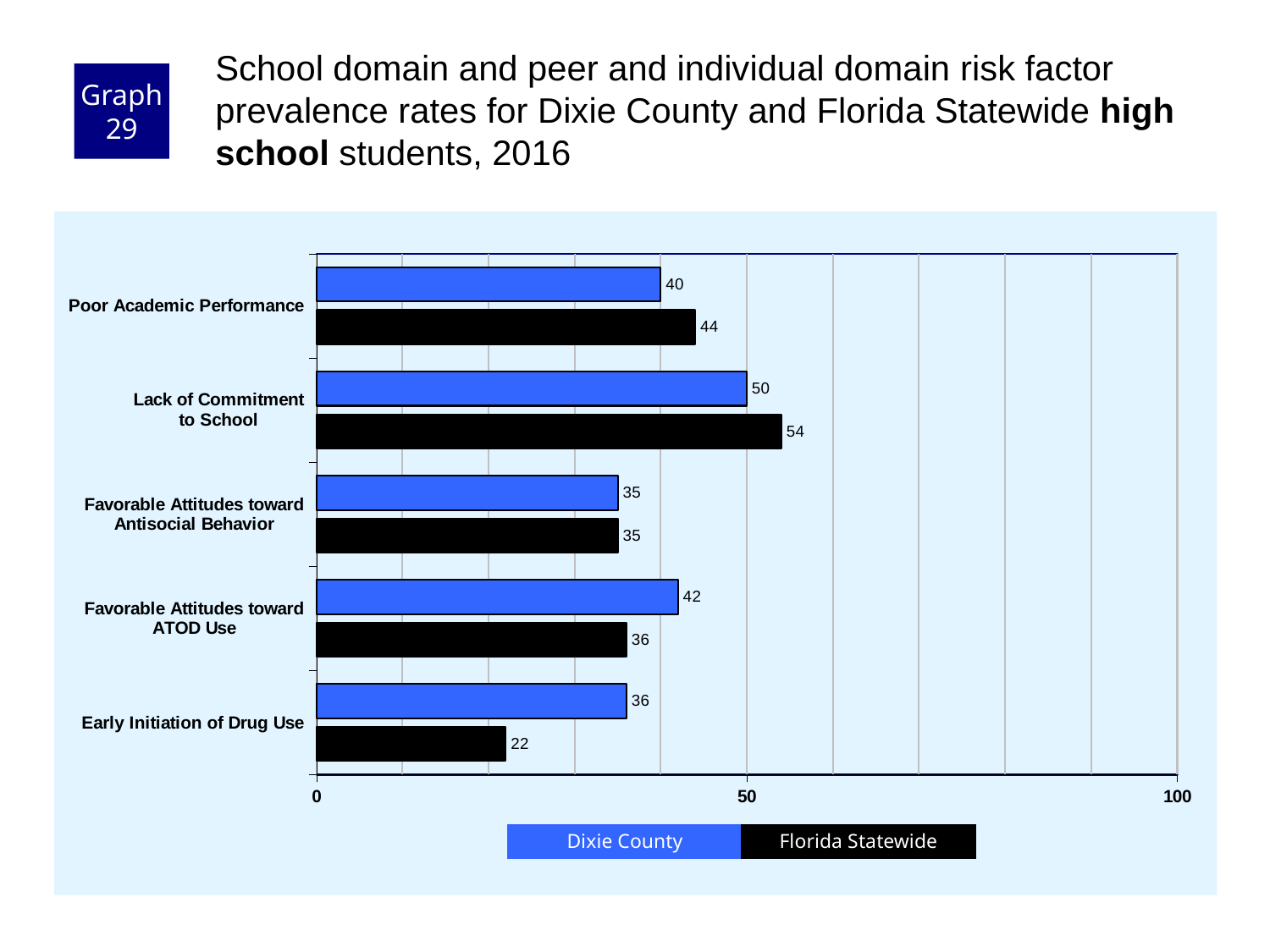
Is the Florida Statewide value for Lack of Commitment to School greater or less than 50? greater What is the Florida Statewide value for Early Initiation of Drug Use? 22 Which category has the highest Florida Statewide value? Lack of Commitment to School What kind of chart is shown on the slide? bar chart What is the Dixie County value for Lack of Commitment to School? 50 Which colour represents Florida Statewide in the chart? black Which category has the lowest Dixie County value? Favorable Attitudes toward Antisocial Behavior What is the Florida Statewide value for Poor Academic Performance? 44 How many risk factor categories are shown on the chart? 5 How many series does the legend list? 2 For Favorable Attitudes toward ATOD Use, which is larger: Dixie County or Florida Statewide? Dixie County What is the difference between the Dixie County and Florida Statewide values for Early Initiation of Drug Use? 14